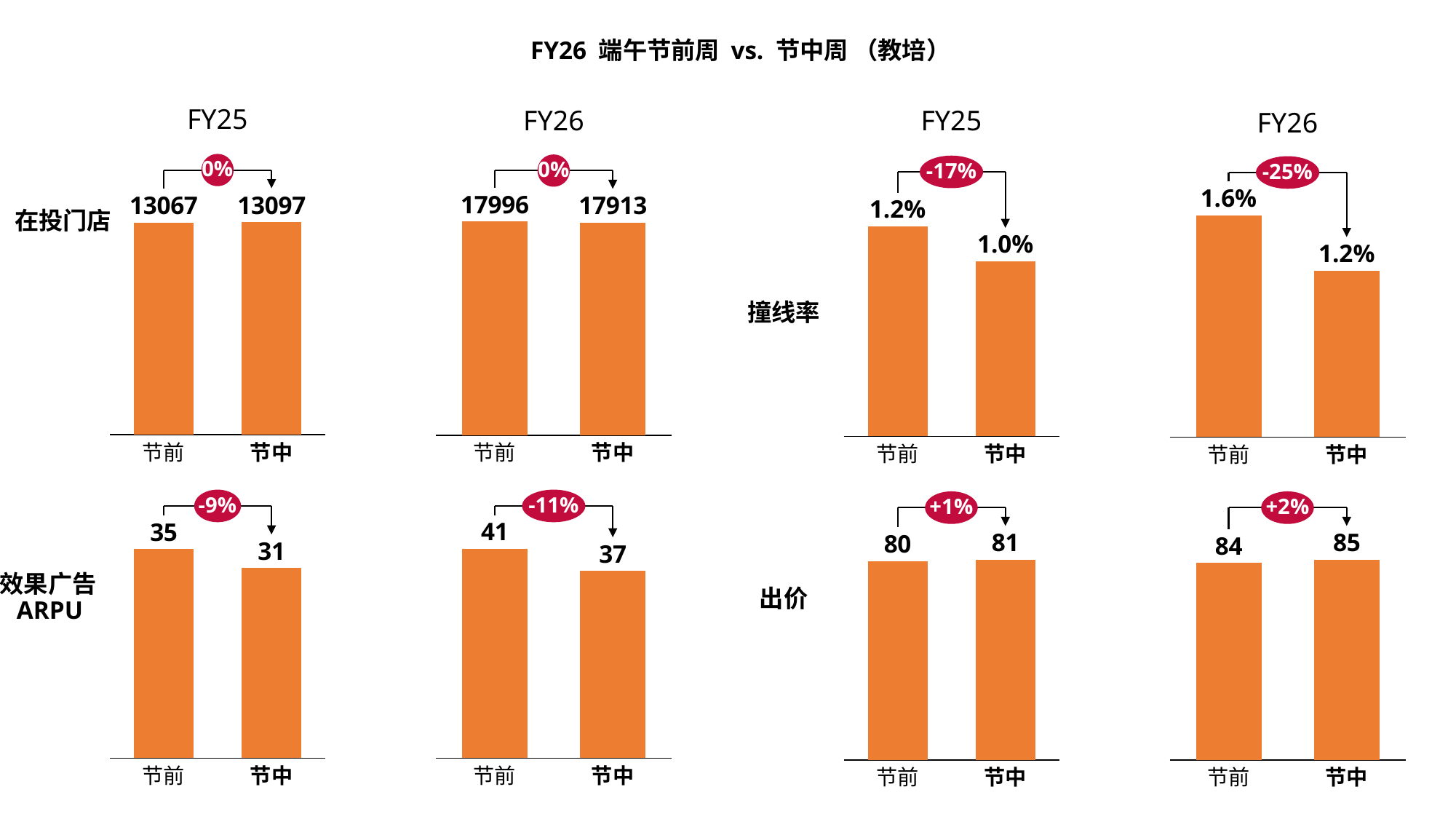
In the 效果广告ARPU FY25 chart, which category has the lowest value? 节中 How many bars are in the 撞线率 FY25 chart? 2 In the 效果广告ARPU FY26 chart, what is the difference between the 节前 and 节中 values? 4 In the 出价 FY26 chart, which bar is higher, 节前 or 节中? 节中 In the 撞线率 FY26 chart, what is the value for 节前? 1.6% In the 在投门店 FY26 chart, what is the value for 节中? 17913 In the 出价 FY25 chart, what is the value for 节前? 80 In the 在投门店 FY26 chart, what is the difference between the 节前 and 节中 values? 83 What type of chart is used for 效果广告ARPU FY26? Bar chart In the 撞线率 FY25 chart, what is the value for 节中? 1.0% In the 在投门店 FY25 chart, what is the value for 节前? 13067 What percentage change is shown in the bubble above the 撞线率 FY26 chart? -25%